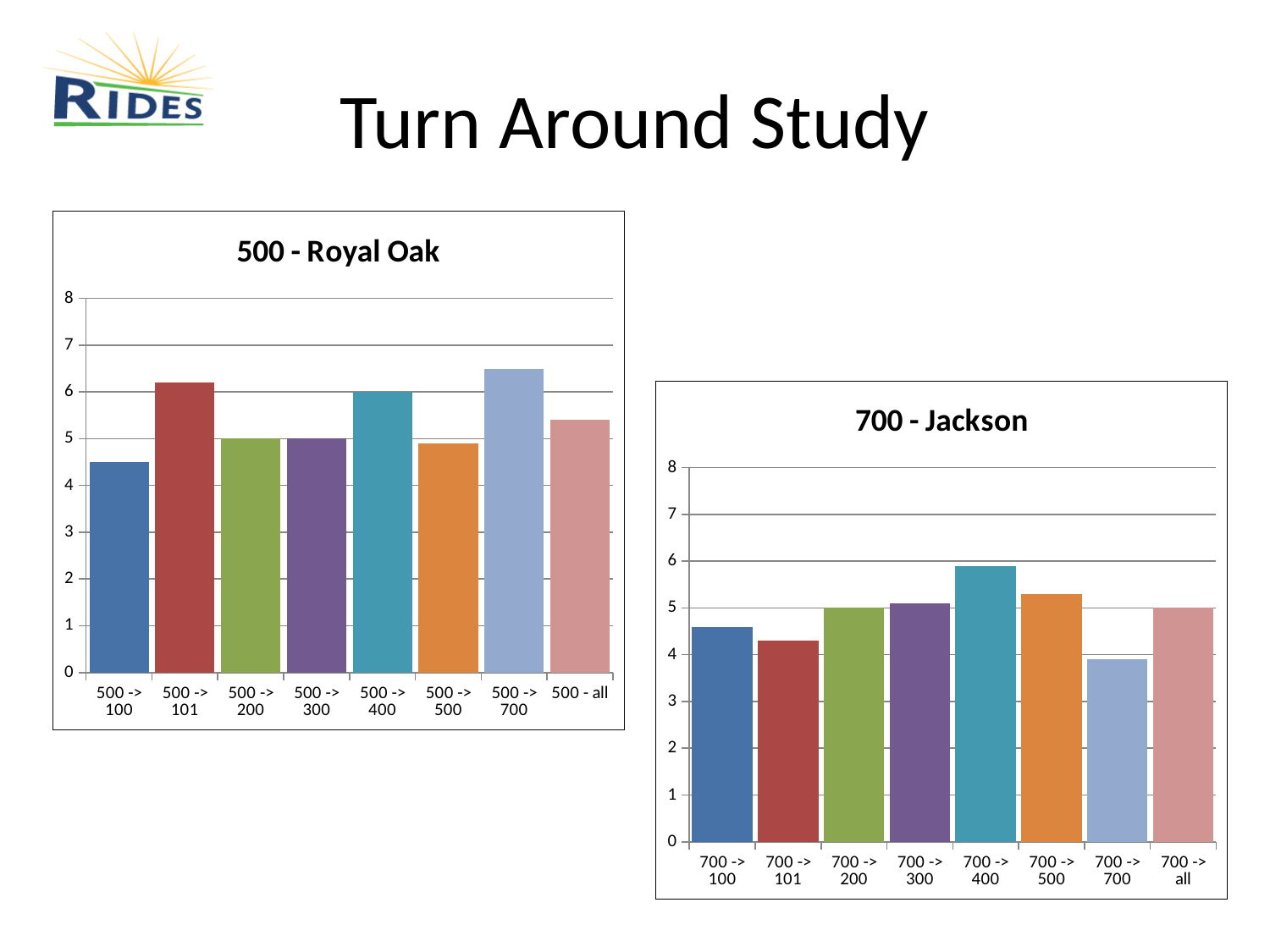
In the 700 - Jackson chart, which is larger, the value for 700 -> 100 or the value for 700 -> 400? 700 -> 400 In the 500 - Royal Oak chart, how many categories are shown on the x axis? 8 In the 500 - Royal Oak chart, which category has the lowest bar? 500 -> 100 In the 500 - Royal Oak chart, is the value for 500 -> 101 greater or less than 6? greater In the 500 - Royal Oak chart, which category has the highest bar? 500 -> 700 In the 700 - Jackson chart, what is the value for 700 -> all? 5 In the 700 - Jackson chart, which category has the lowest bar? 700 -> 700 What kind of chart is the 700 - Jackson chart? bar chart What is the title of the chart on the left side of the slide? 500 - Royal Oak In the 700 - Jackson chart, which category has the highest bar? 700 -> 400 In the 500 - Royal Oak chart, what is the value for 500 -> 400? 6